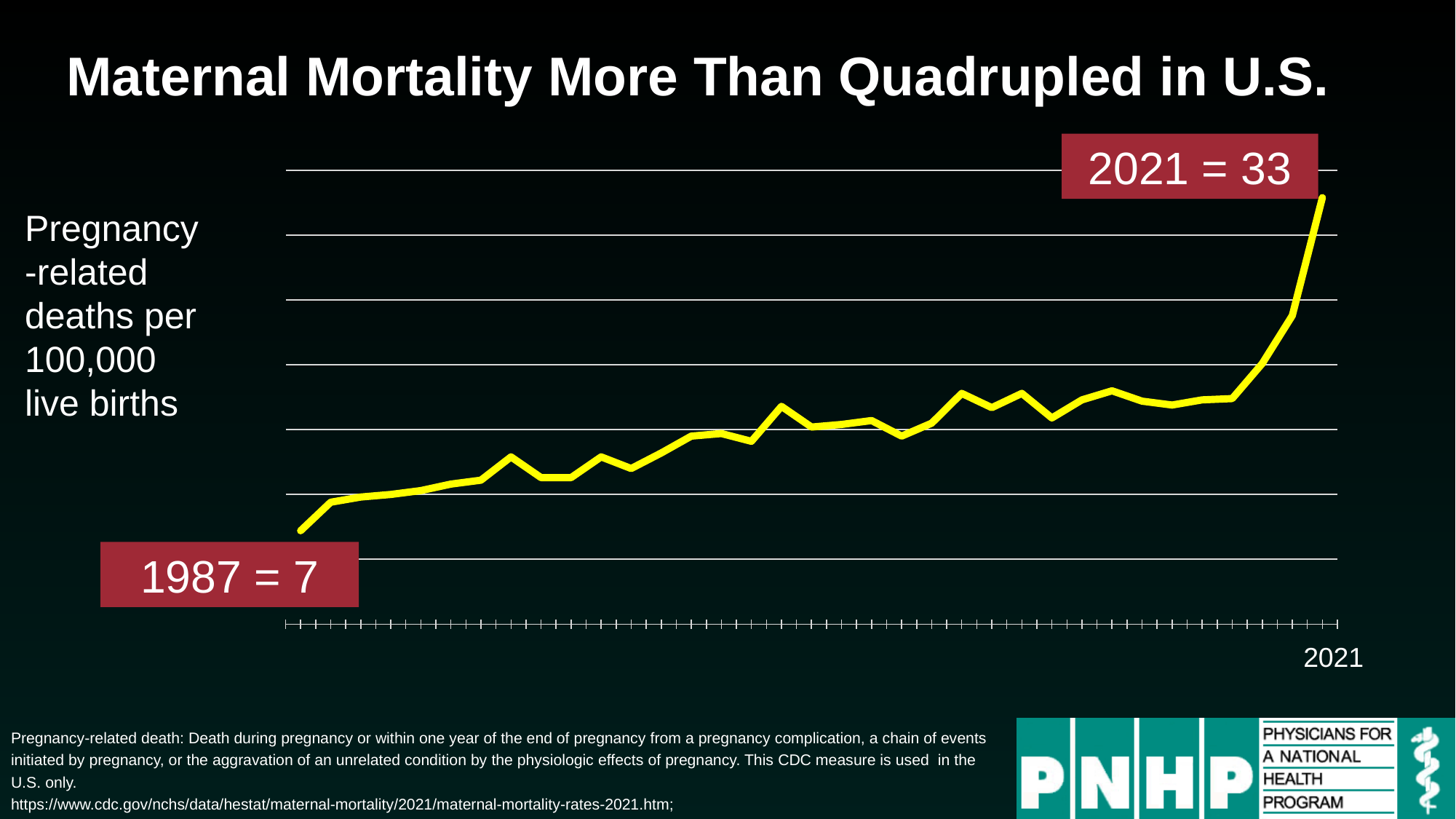
Do the values generally rise or fall from 1987 to 2021? Rise What colour is the plotted line? Yellow What is the value for 2021? 33 What is the difference between the 2021 value and the 1987 value? 26 What is the title of the slide? Maternal Mortality More Than Quadrupled in U.S. Which year has the larger value, 1987 or 2021? 2021 What kind of chart is shown on the slide? Line chart What is the value for 1987? 7 Which year has the highest value on the chart? 2021 Which year has the lowest value on the chart? 1987